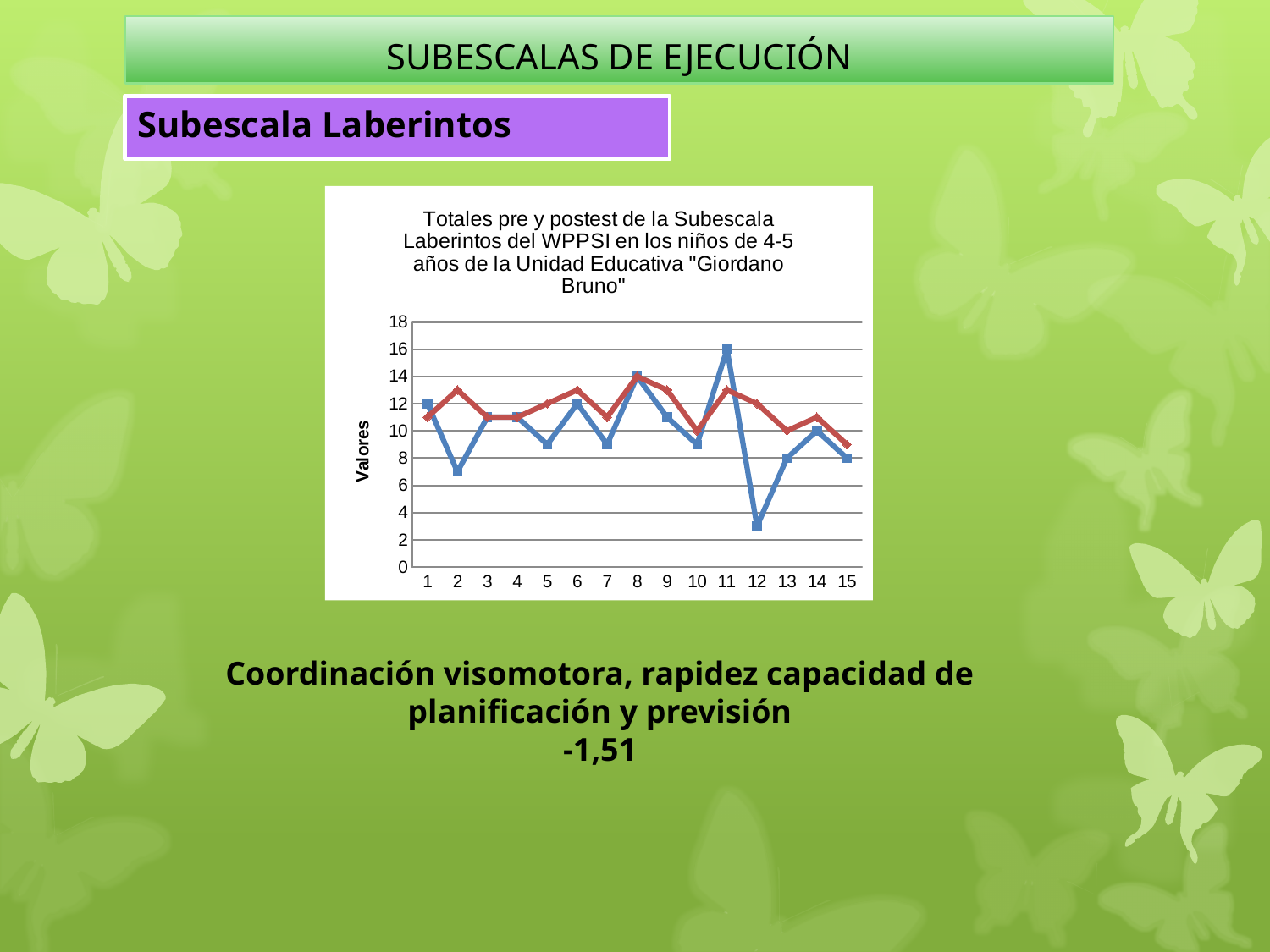
At point 12, which line has the higher value, the red line or the blue line? red line Is the value of the blue line at point 12 greater or less than 4? less What is the label on the vertical axis of the chart? Valores What is the difference between the red line (10) and the blue line (8) at point 13? 2 What kind of chart is shown on the slide? line chart At which x-axis point does the blue line reach its highest value? 11 How many points are plotted along the x axis of the chart? 15 At which x-axis point does the blue line reach its lowest value? 12 What is the value of the red line at point 8? 14 How many lines (series) are plotted in the chart? 2 Is the value of the red line at point 2 greater or less than 12? greater What is the value of the blue line at point 11? 16